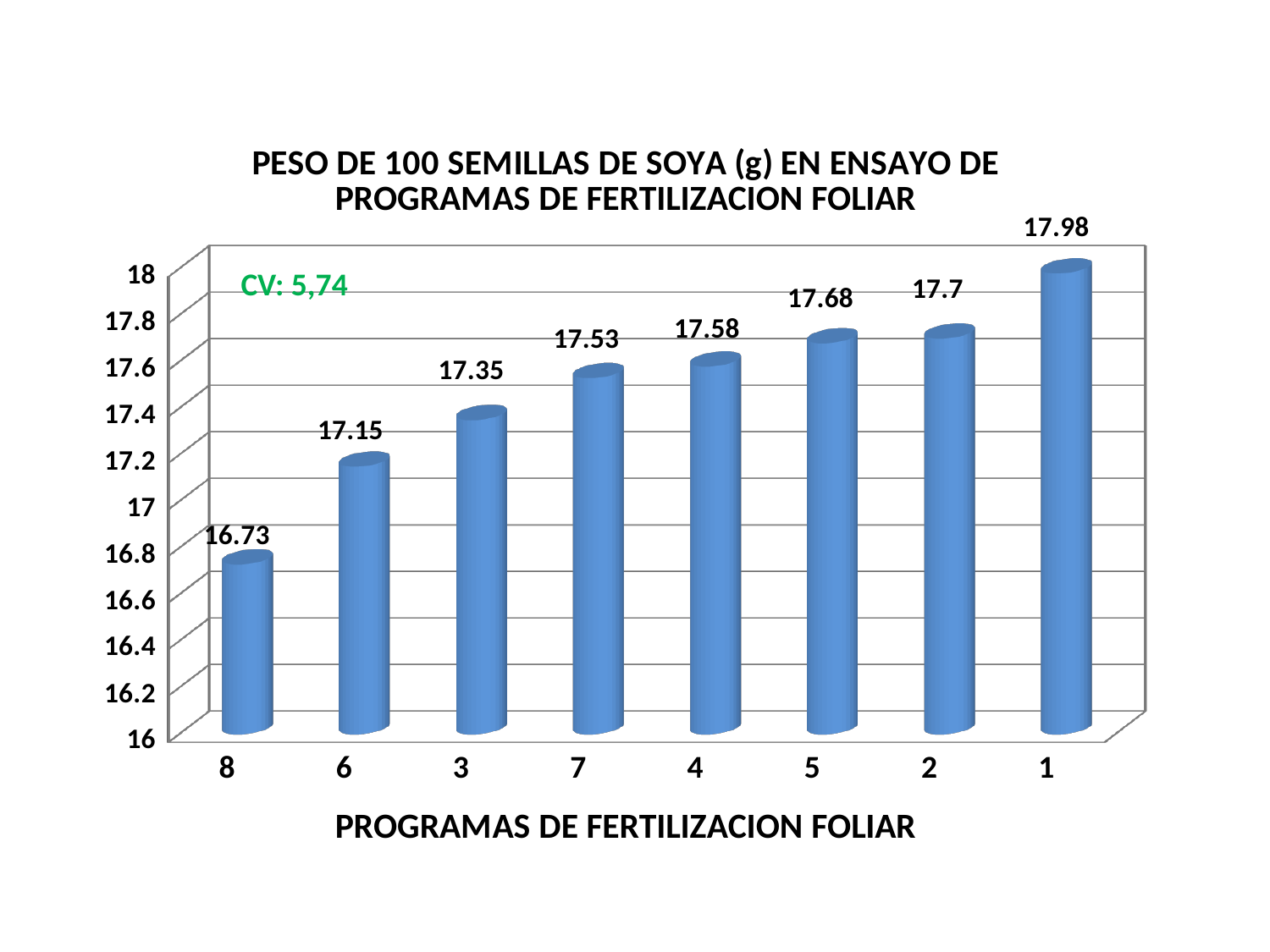
Which has a larger value, program 7 or program 2? 2 Which fertilization program has the highest seed weight? 1 What kind of chart is shown on the slide? bar chart How many fertilization programs are shown on the chart? 8 What is the difference between the values for program 1 and program 8? 1.25 What is the value shown for program 3? 17.35 What is the weight of 100 soybean seeds for fertilization program 8? 16.73 Do the values rise or fall from left to right along the x axis? rise What is the value shown for program 5? 17.68 What is the difference between the values for program 6 and program 3? 0.2 Which fertilization program has the lowest seed weight? 8 What CV value is printed on the chart? 5,74